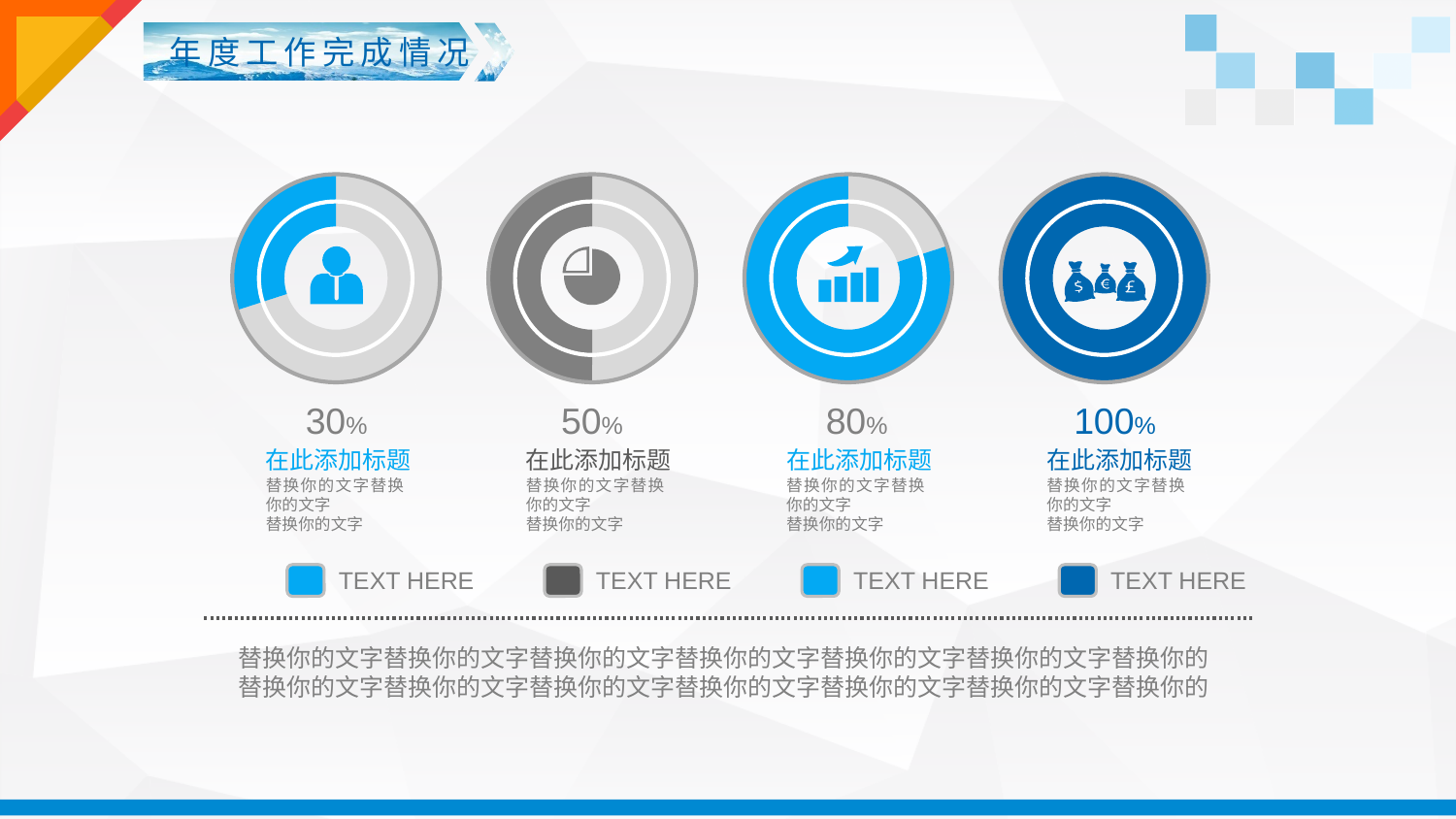
What kind of chart is used to display each percentage on the slide? Donut (ring) chart What percentage is shown below the fourth (rightmost) ring chart with the money bag icon? 100% Which of the four ring charts shows the lowest percentage? The first (leftmost) chart, 30% What colour is the filled portion of the second ring chart (50%)? Grey What is the difference between the percentage of the third ring chart and the first ring chart? 50% Which of the four ring charts shows the highest percentage? The fourth (rightmost) chart, 100% Do the percentages increase or decrease from the leftmost chart to the rightmost chart? Increase What percentage is shown below the third ring chart with the bar-chart-and-arrow icon? 80% Which is larger, the percentage of the second ring chart or the third ring chart? The third ring chart (80%) What percentage is shown below the first (leftmost) ring chart with the person icon? 30% What percentage is shown below the second ring chart with the pie icon? 50% How many ring charts are shown on the slide? 4